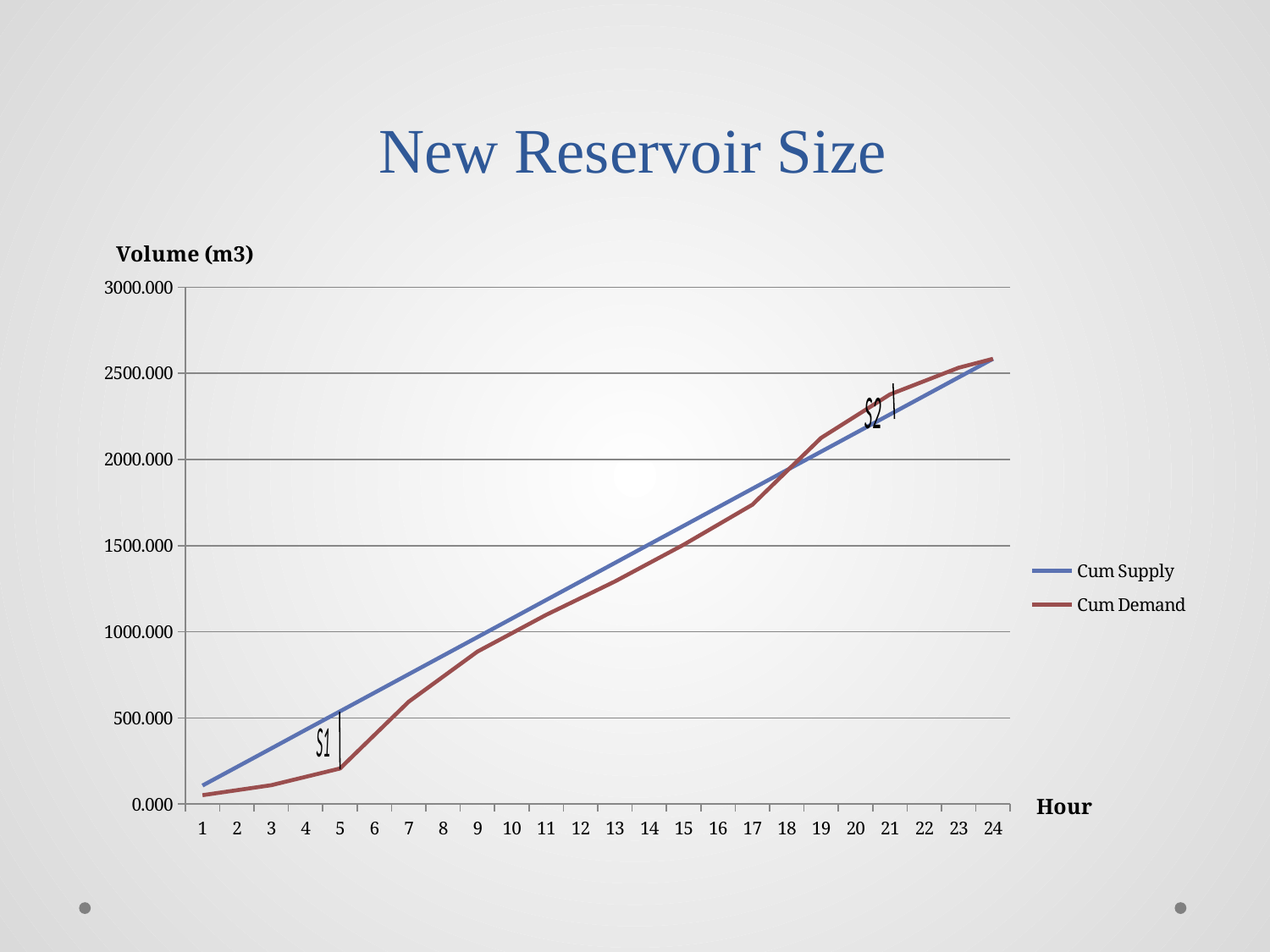
How many series does the legend list? 2 Is the Cum Demand value at hour 19 greater or less than 2000.000? greater Is the Cum Demand value at hour 17 greater or less than 1500.000? greater Is the Cum Demand value at hour 5 greater or less than 500.000? less At hour 5, which series has the larger value, Cum Supply or Cum Demand? Cum Supply Does the Cum Supply line rise or fall from hour 1 to hour 24? rise What is the label of the vertical axis? Volume (m3) How many hours are shown along the x axis? 24 What kind of chart is shown on the slide? line chart At hour 20, which series has the larger value, Cum Supply or Cum Demand? Cum Demand Does the Cum Demand line rise or fall as the hour increases? rise